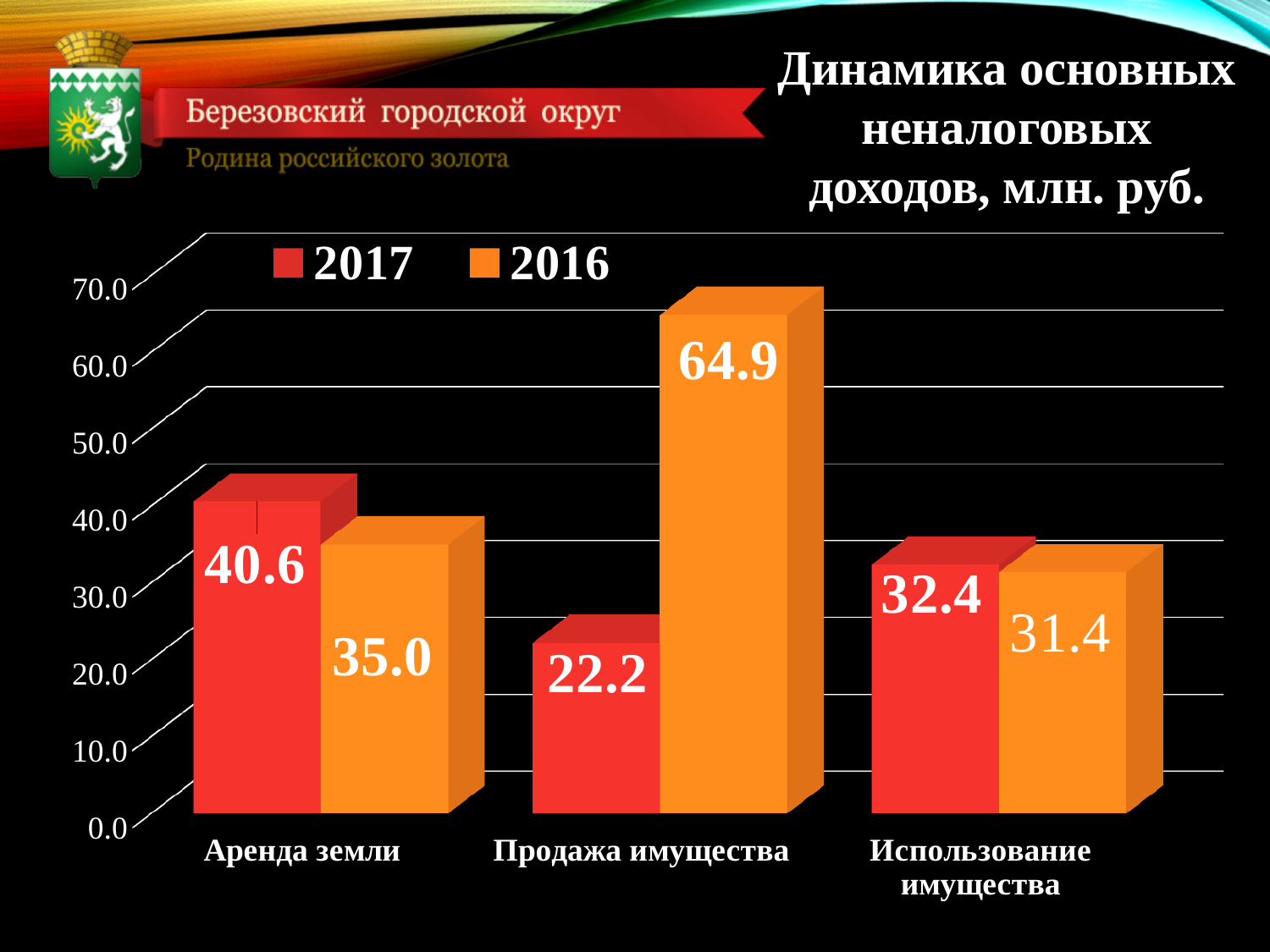
What is the 2016 value for Использование имущества? 31.4 Which category has the lowest 2017 value? Продажа имущества What is the 2017 value for Аренда земли? 40.6 How many series does the legend list? 2 What is the 2017 value for Продажа имущества? 22.2 What is the difference between the 2017 and 2016 values for Аренда земли? 5.6 What is the 2016 value for Продажа имущества? 64.9 Which category has the highest 2016 value? Продажа имущества What kind of chart is shown on the slide? bar chart What is the difference between the 2016 and 2017 values for Продажа имущества? 42.7 How many categories are shown on the x axis? 3 Which is larger for Аренда земли, the 2017 value or the 2016 value? 2017